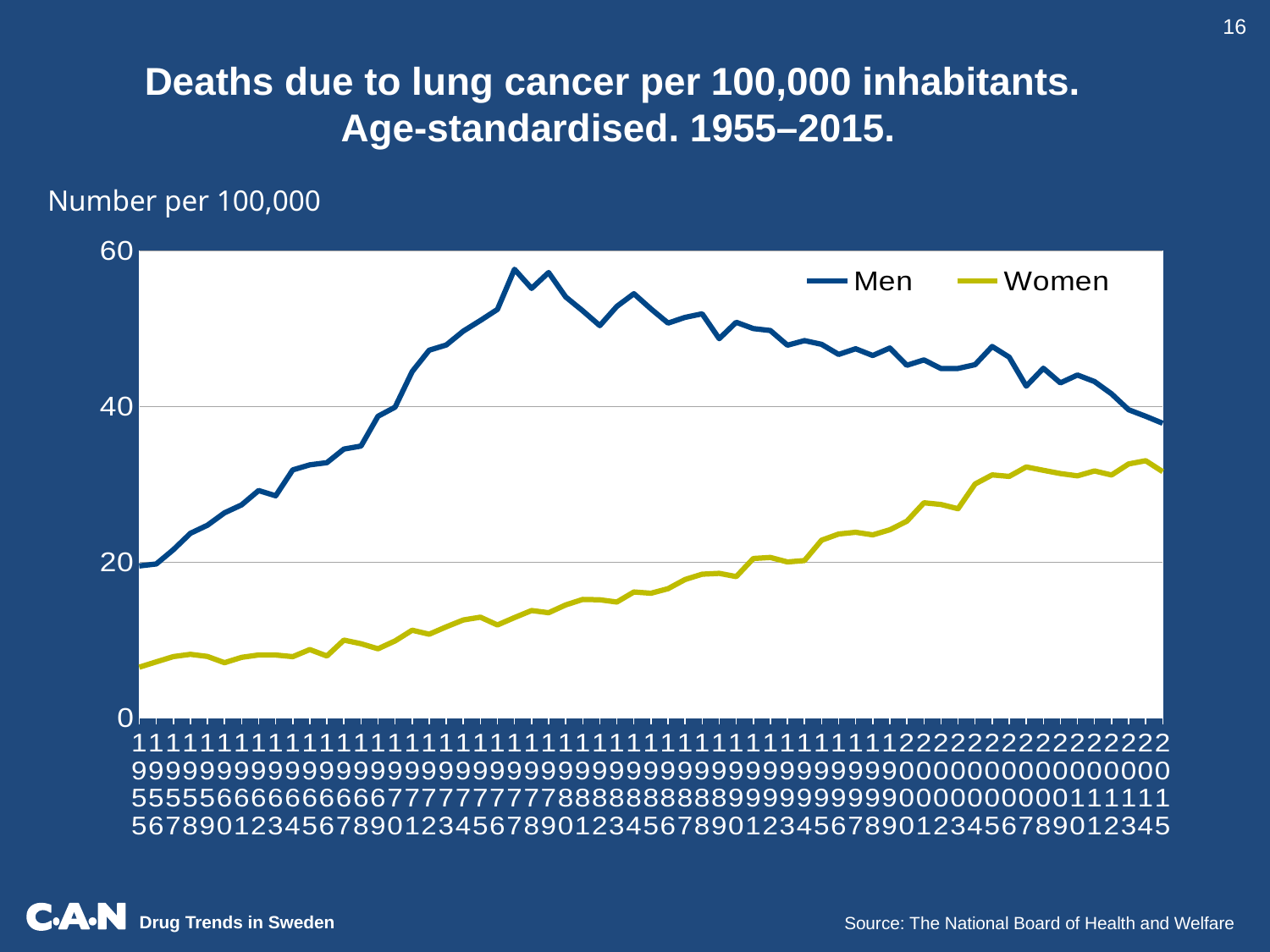
What is the label shown above the y axis? Number per 100,000 What are the two series shown in the legend? Men and Women What kind of chart is shown on the slide? Line chart Is the value for Men in 1980 greater or less than 40? greater Which series has the higher value in 1980, Men or Women? Men Does the Men line rise or fall from 1990 to 2015? Fall How many years are plotted on the x axis? 61 Is the value for Women in 1955 greater or less than 20? less Does the Women line rise or fall overall from 1955 to 2015? Rise Is the value for Women in 1985 greater or less than 20? less How many series does the legend list? 2